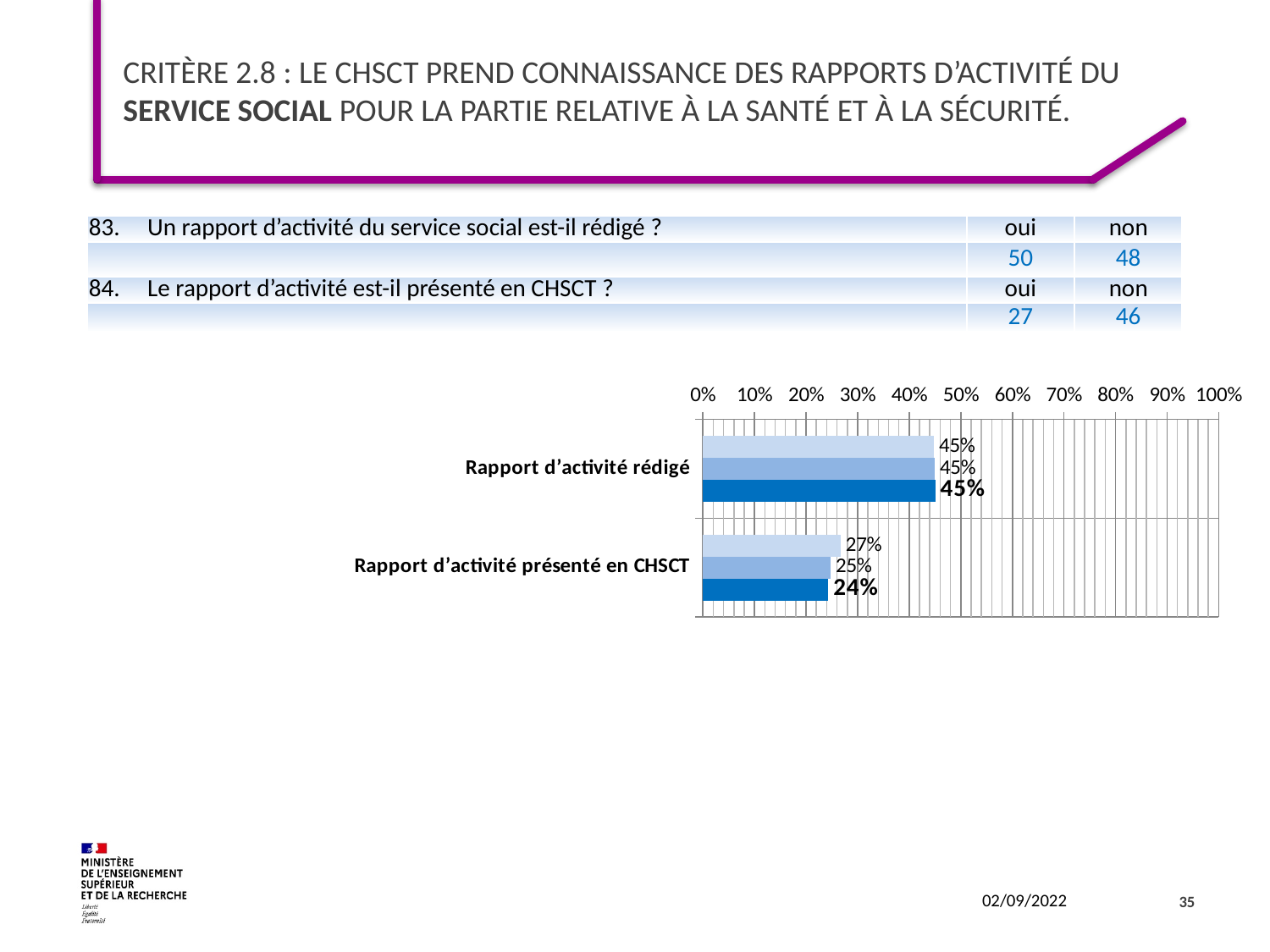
What is the difference between the lightest and darkest blue bars for "Rapport d'activité présenté en CHSCT"? 3% Which category has the higher value for the darkest blue bar? Rapport d'activité rédigé How many bars are drawn for each category on the chart? 3 What kind of chart is shown on the slide? bar chart What is the value of the middle bar for "Rapport d'activité présenté en CHSCT"? 25% How many categories are shown on the chart? 2 What is the difference between the darkest blue bars for "Rapport d'activité rédigé" and "Rapport d'activité présenté en CHSCT"? 21% Is the value of the darkest blue bar for "Rapport d'activité rédigé" greater or less than 40%? greater Which category has the lowest value for the lightest blue bar? Rapport d'activité présenté en CHSCT What is the value of the lightest blue bar for "Rapport d'activité présenté en CHSCT"? 27% What is the value of the darkest blue bar for "Rapport d'activité présenté en CHSCT"? 24% What is the value of the darkest blue bar for "Rapport d'activité rédigé"? 45%